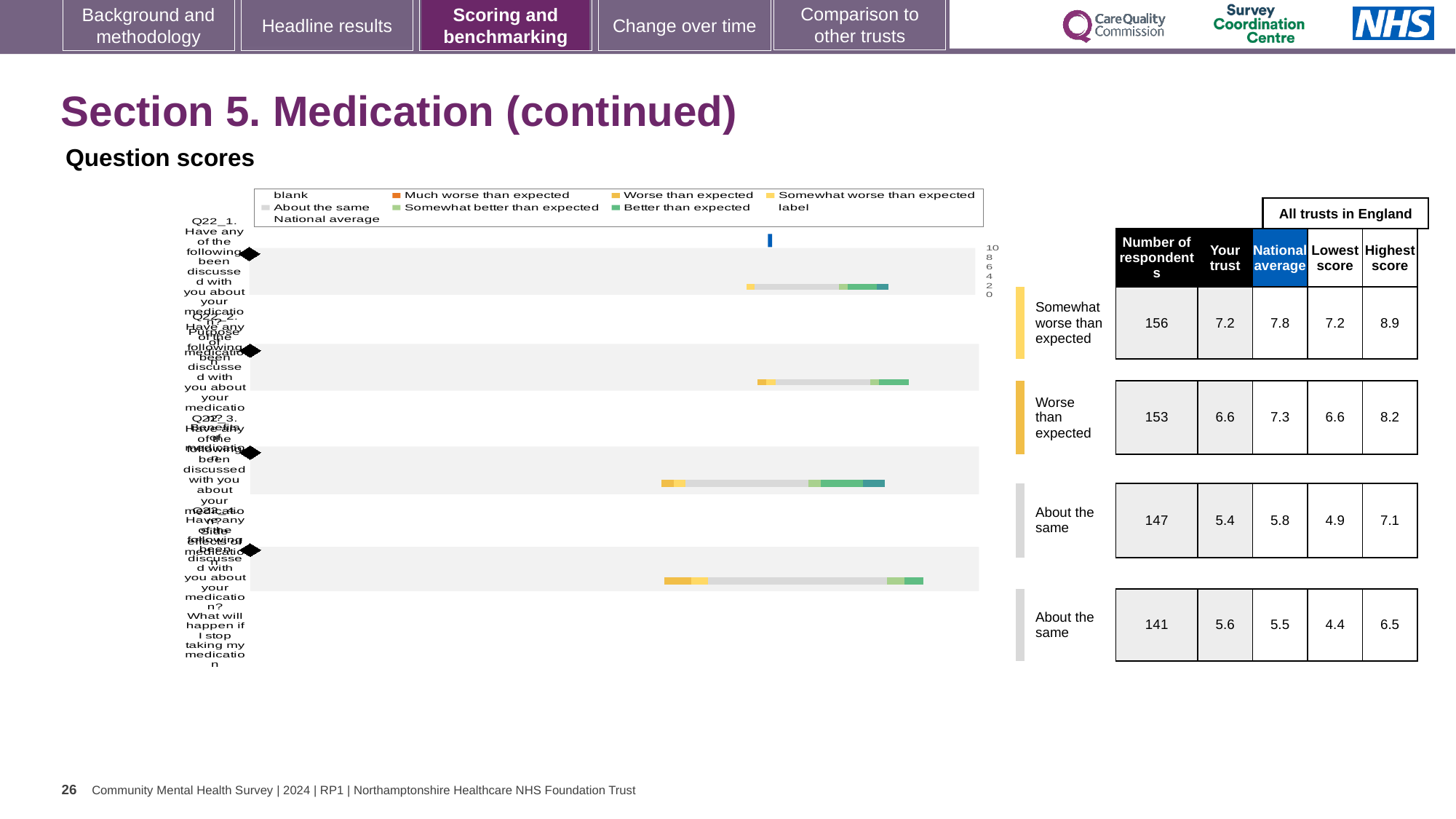
In the table, what is the lowest score for the first row? 7.2 In the table, what is the number of respondents for the first row (Somewhat worse than expected)? 156 In the table, what is the difference between the national average and the 'Your trust' score in the second row? 0.7 In the table, what is the highest score for the fourth row? 6.5 Which row of the table has the highest number of respondents? the first row (Somewhat worse than expected), 156 In the table, what is the 'Your trust' score for the second row (Worse than expected)? 6.6 What heading appears above the Lowest score and Highest score columns of the table? All trusts in England In the fourth row of the table, which is larger: the 'Your trust' score or the national average? Your trust (5.6) What kind of chart is shown on the left of the slide? bar chart How many question rows (bars) does the chart on the left show? 4 Which row of the table has the lowest 'Your trust' score? the third row (About the same), 5.4 In the table, what is the national average for the third row? 5.8